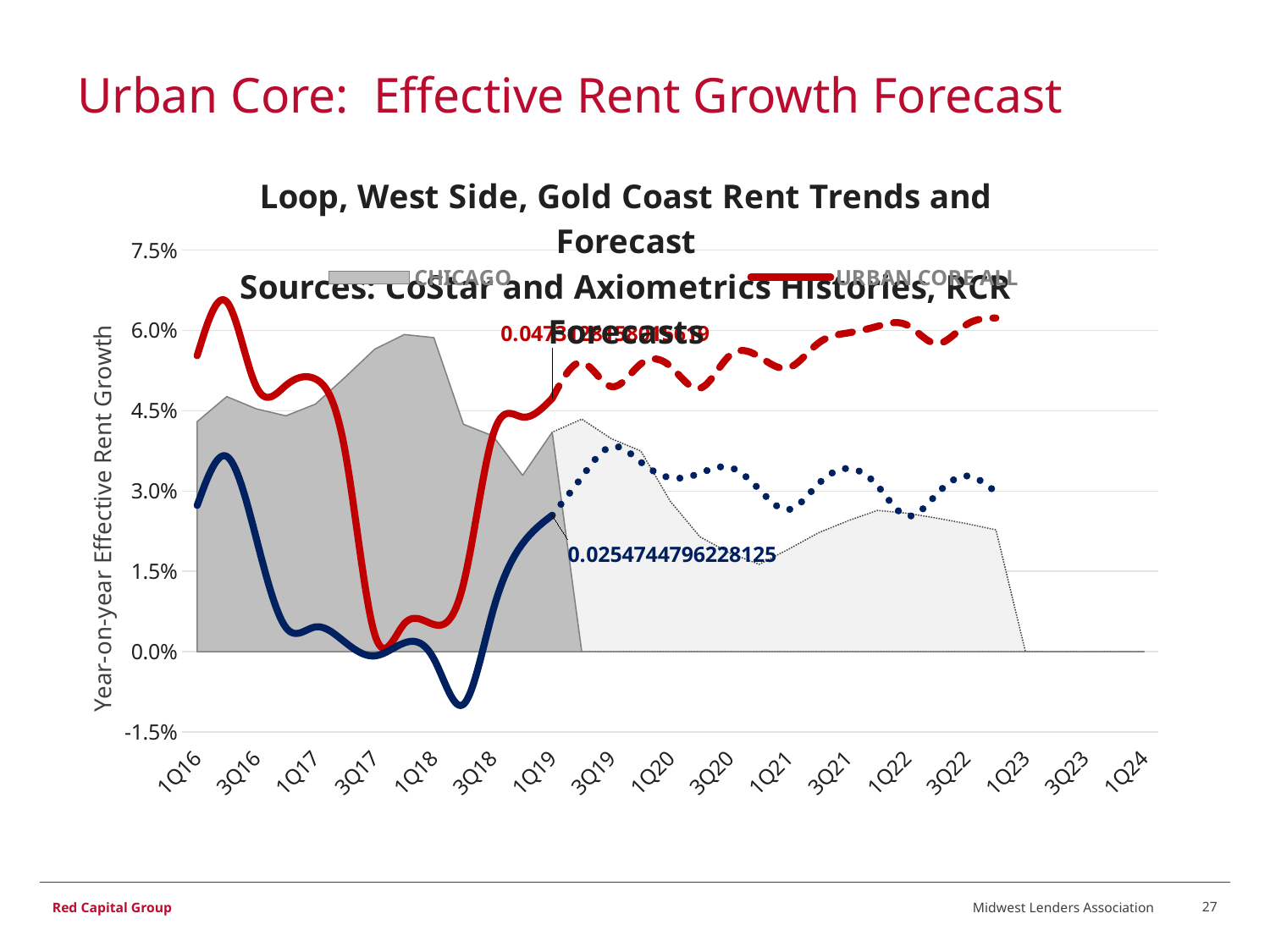
At 1Q16, which is higher: the red URBAN CORE ALL line or the dark blue line? the red URBAN CORE ALL line What is the title of the chart? Loop, West Side, Gold Coast Rent Trends and Forecast Sources: CoStar and Axiometrics Histories, RCR Forecasts Is the value of the gray CHICAGO area at 1Q18 greater or less than 4.5%? greater How many quarter labels are shown along the x axis of the chart? 17 What is the label on the vertical axis of the chart? Year-on-year Effective Rent Growth What is the highest value shown on the vertical axis of the chart? 7.5% Is the value of the red URBAN CORE ALL line at 3Q17 greater or less than 1.5%? less Does the red URBAN CORE ALL line rise or fall between 3Q16 and 3Q17? fall Is the value of the red URBAN CORE ALL line at 1Q16 greater or less than 4.5%? greater What data label is printed on the dark blue line at 1Q19? 0.0254744796228125 How many series does the chart legend list? 2